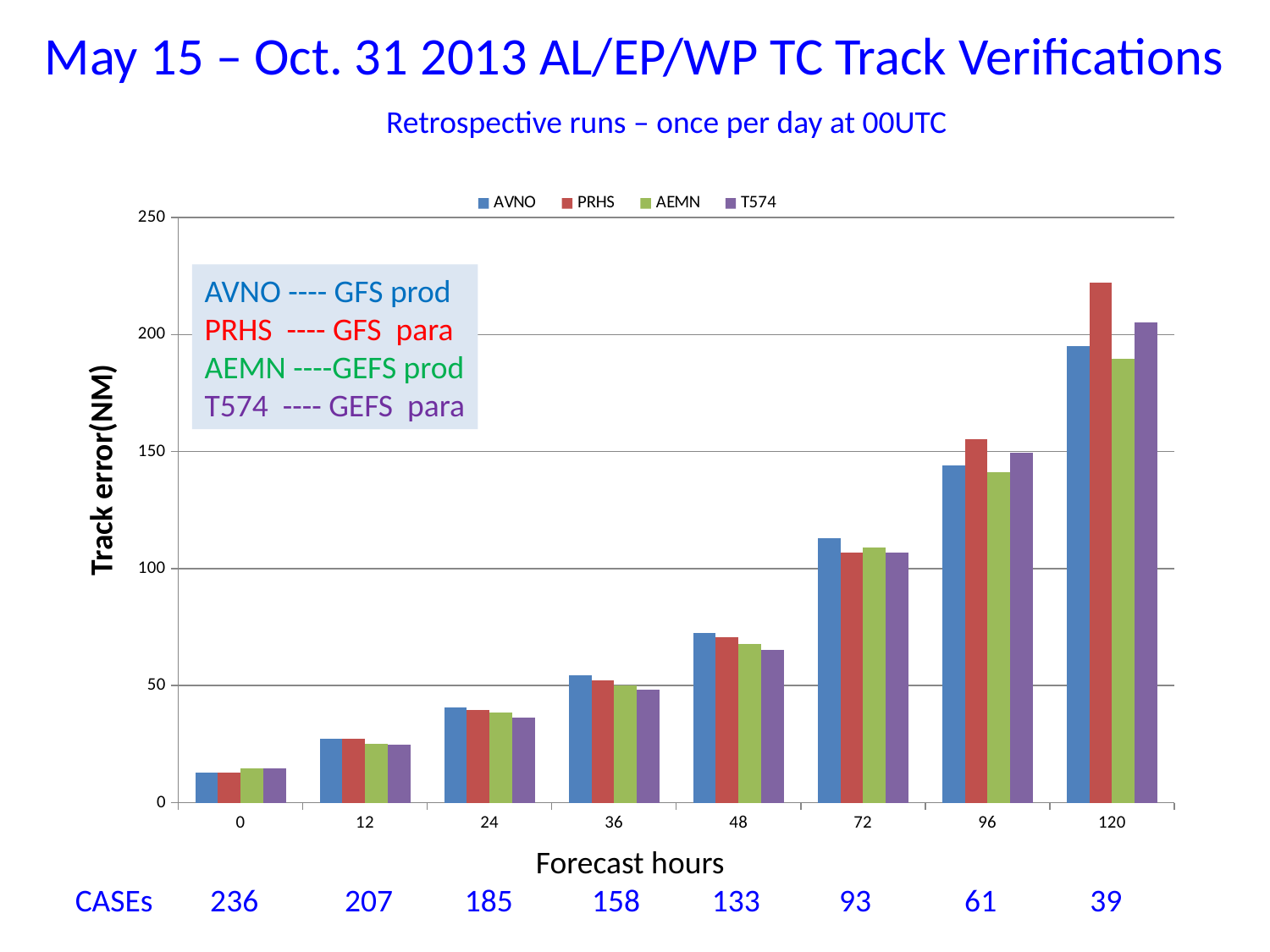
Do the track error values rise or fall as forecast hours increase along the x axis? rise How many forecast-hour categories are plotted along the x axis? 8 Is the AEMN value at forecast hour 120 greater or less than 200? less Which series has the lowest track error at forecast hour 120? AEMN Is the AVNO value at forecast hour 72 greater or less than 100? greater Which series has the highest track error at forecast hour 120? PRHS What kind of chart is shown on the slide? bar chart Is the AVNO value at forecast hour 96 greater or less than 150? less How many series does the chart legend list? 4 What is the title of the vertical axis? Track error(NM) At forecast hour 96, which is larger: the PRHS value or the AEMN value? PRHS